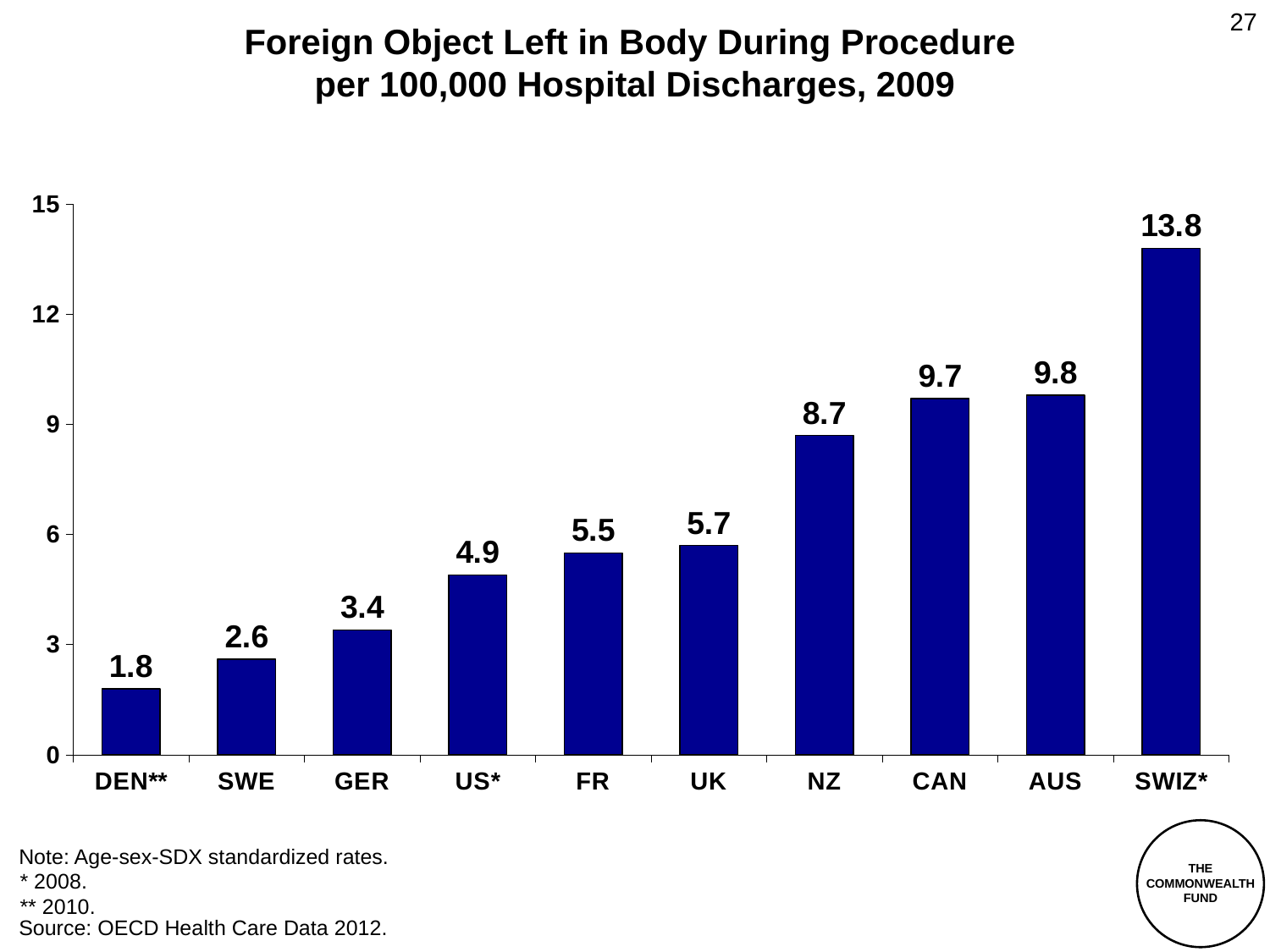
Is the value for CAN greater or less than 9? greater What is the difference between the values for UK and FR? 0.2 What is the value for NZ? 8.7 Do the values rise or fall from left to right along the x axis? Rise What kind of chart is shown on the slide? Bar chart What is the value for US*? 4.9 What is the difference between the values for SWIZ* and AUS? 4.0 Which country has the lowest rate? DEN** Which country has the highest rate of foreign objects left in body? SWIZ* What is the value for DEN**? 1.8 How many countries are shown in the chart? 10 Which is larger, the value for GER or the value for SWE? GER